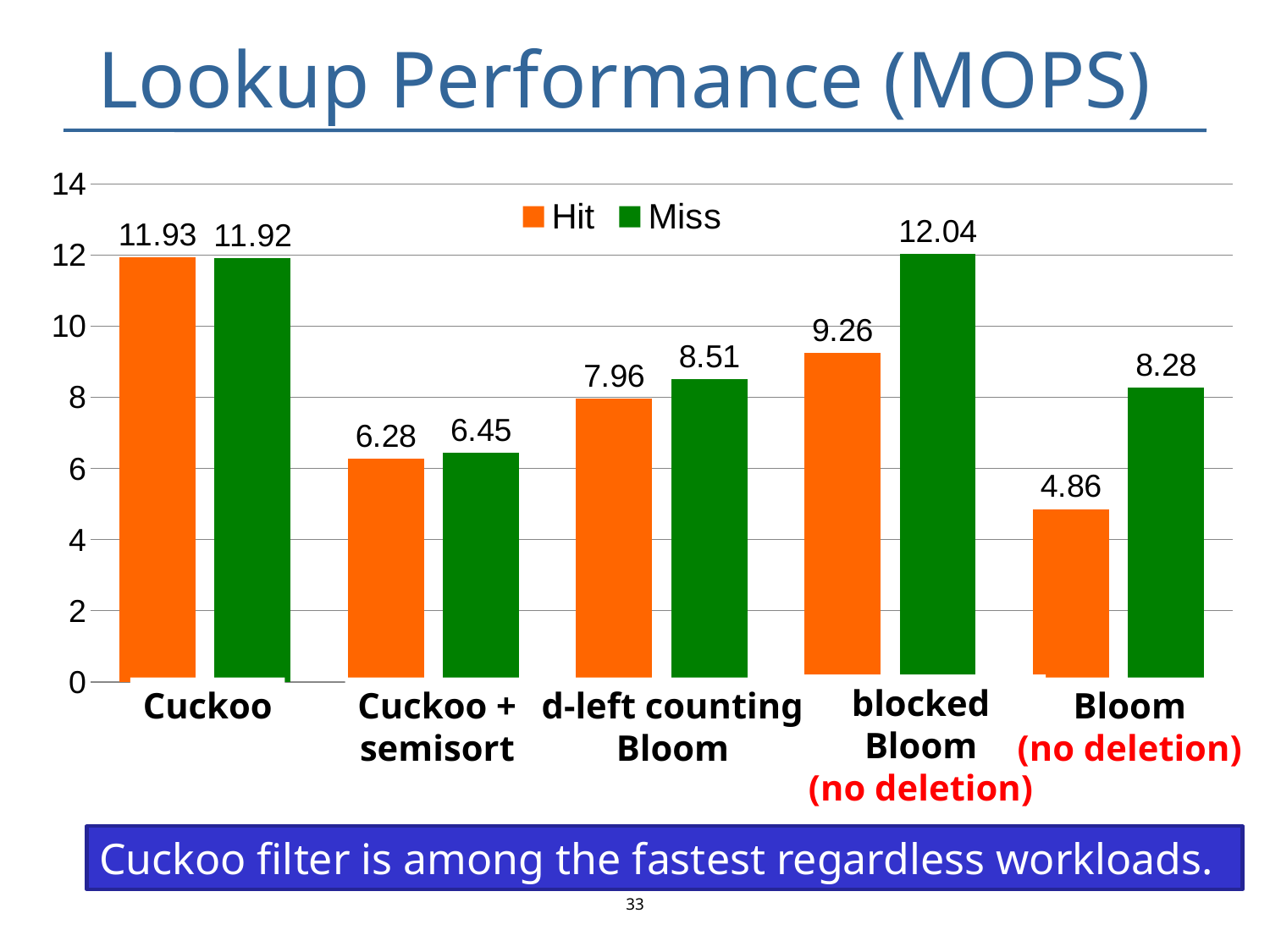
Which is larger for d-left counting Bloom, the Hit value or the Miss value? Miss How many categories are shown on the x axis? 5 How many series does the legend list? 2 What kind of chart is shown on the slide? bar chart Is the Hit value for blocked Bloom (no deletion) greater or less than 10? less What is the difference between the Miss and Hit values for Bloom (no deletion)? 3.42 Which category has the lowest Hit value? Bloom (no deletion) What is the Miss lookup performance for blocked Bloom (no deletion)? 12.04 What is the Hit value for Bloom (no deletion)? 4.86 What colour represents the Miss series? green Which category has the highest Miss value? blocked Bloom (no deletion) What is the Hit lookup performance for Cuckoo? 11.93